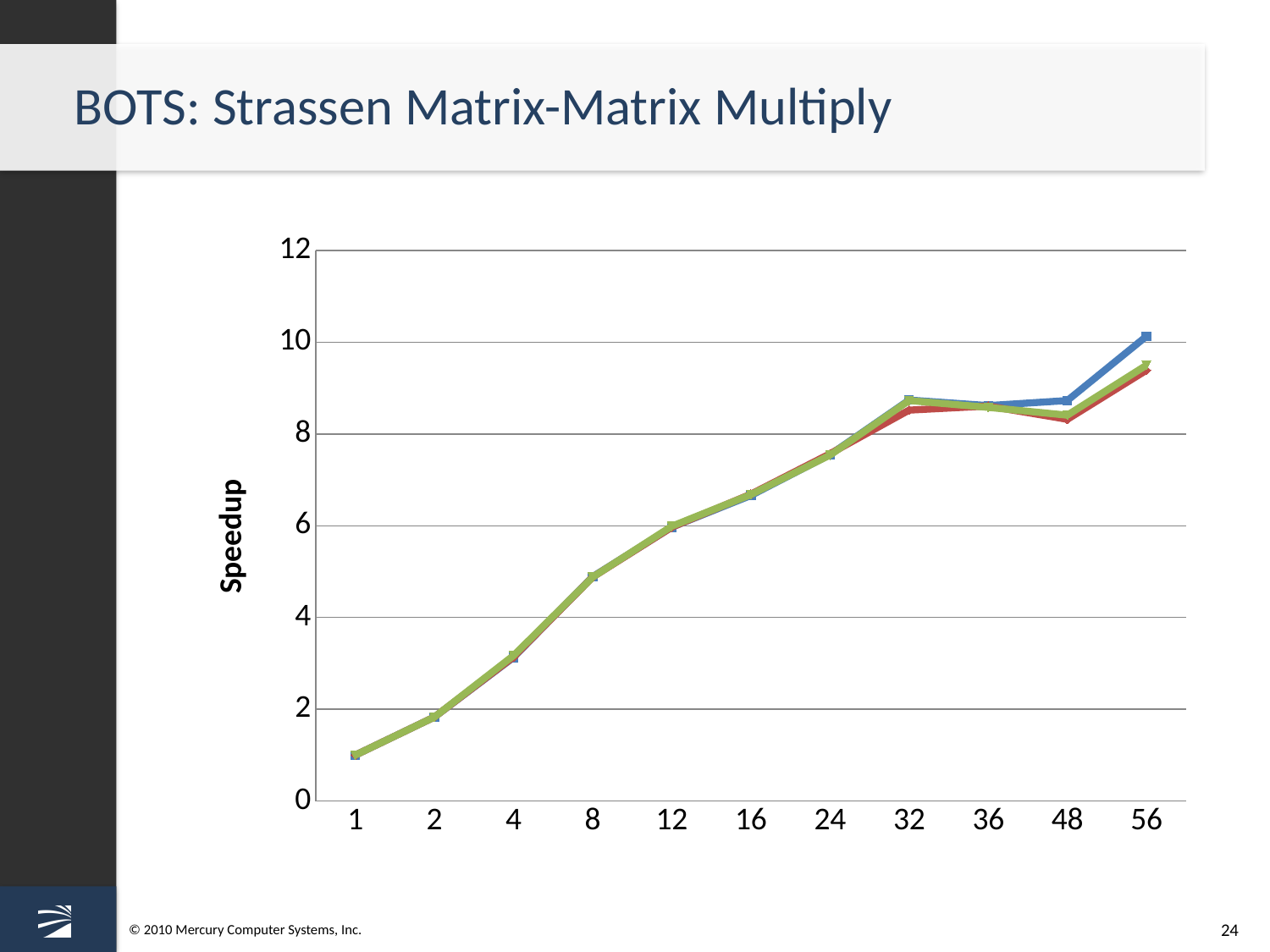
Is the speedup of the blue line at x = 56 greater or less than 9? greater How many lines are plotted on the chart? 3 How many points are labelled along the x axis of the chart? 11 What is the label on the y axis of the chart? Speedup Is the speedup at x = 8 greater or less than 4? greater Does the speedup rise or fall along the x axis from 1 to 32? rise What is the title of the slide containing the chart? BOTS: Strassen Matrix-Matrix Multiply What kind of chart is shown on the slide? line chart Is the speedup at x = 1 greater or less than 2? less At x = 48, which line has the higher speedup, the blue line or the red line? blue line At which x-axis value does the blue line reach its highest speedup? 56